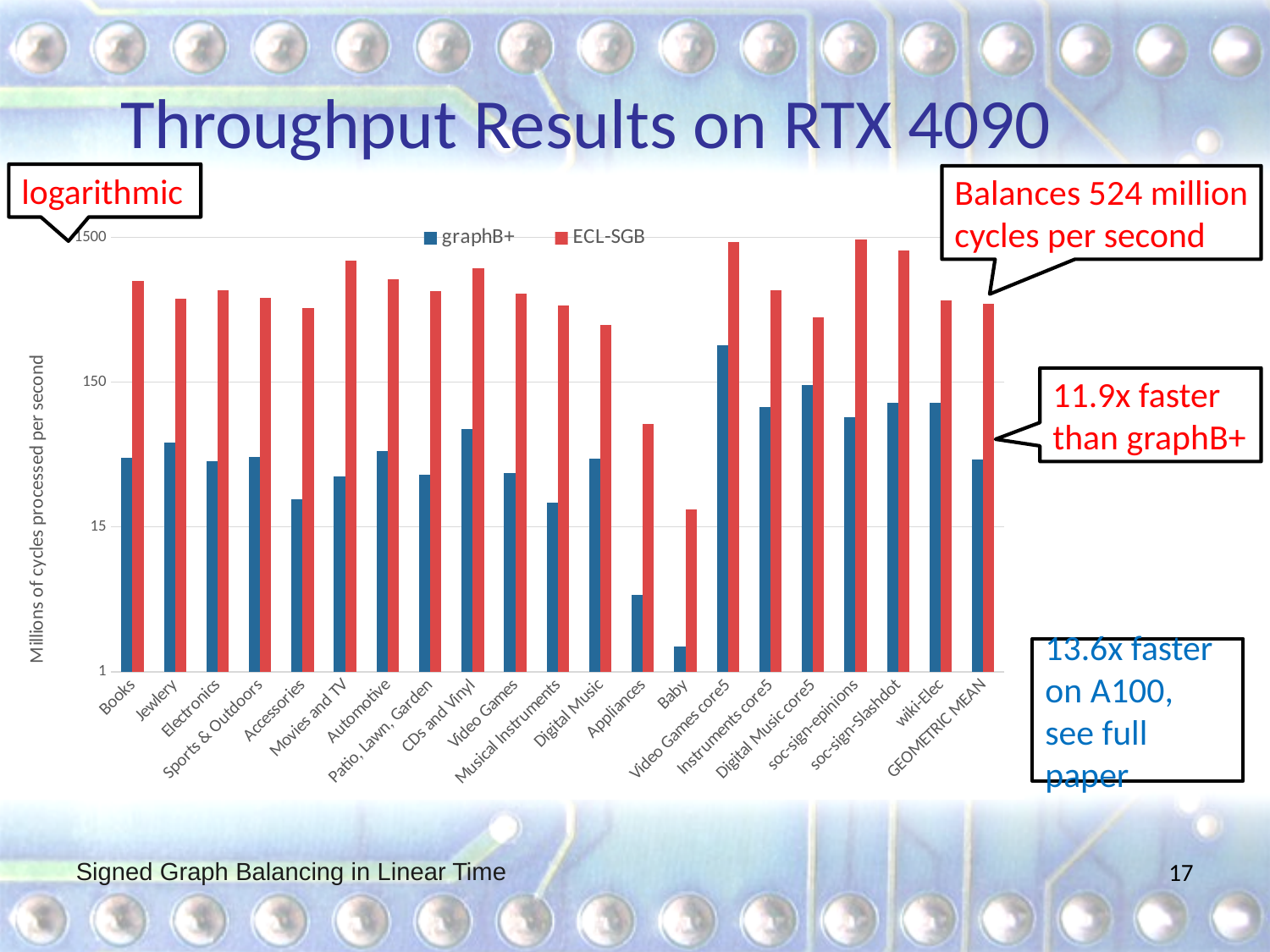
Which category has the lowest graphB+ value? Baby What kind of chart is shown on the slide? bar chart What are the two series named in the chart's legend? graphB+ and ECL-SGB What kind of scale does the chart's y axis use, according to the callout on the slide? logarithmic How many series does the chart's legend list? 2 Is the ECL-SGB value for Books greater or less than 150? greater Which category has the highest graphB+ value? Video Games core5 Is the graphB+ value for Appliances greater or less than 15? less How many categories are shown along the x axis of the chart? 21 For Books, which series has the larger value, graphB+ or ECL-SGB? ECL-SGB Is the graphB+ value for Video Games core5 greater or less than 150? greater